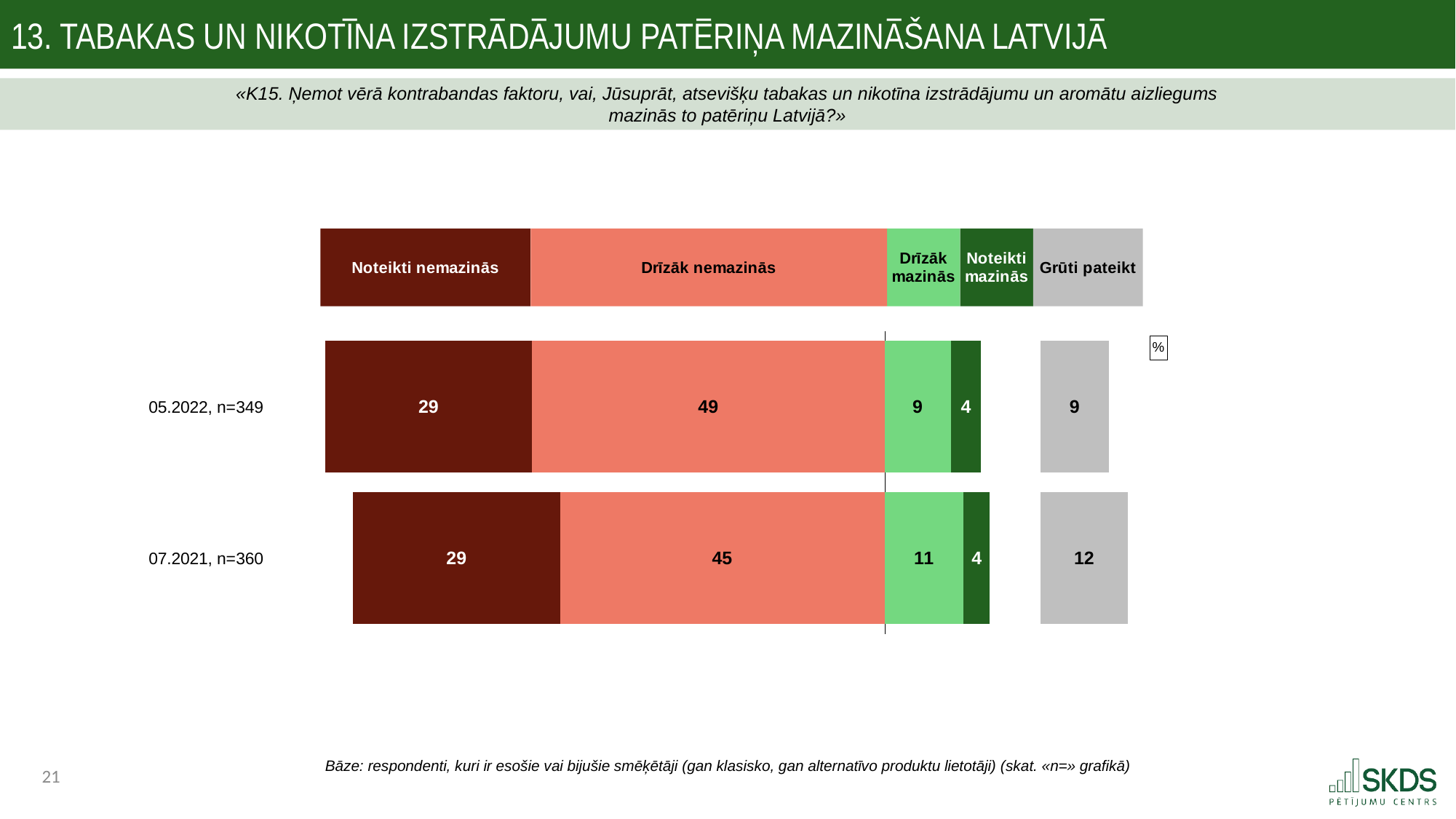
How many survey waves (rows) are shown in the chart? 2 What is the sample size (n) for the 05.2022 row? 349 What is the value for "Grūti pateikt" in the 07.2021 row? 12 How many response categories does the legend list? 5 What kind of chart is shown on the slide? Stacked bar chart Which response category has the highest value in the 07.2021 row? Drīzāk nemazinās What percentage of respondents in 05.2022 answered "Drīzāk nemazinās"? 49 Which row has the larger value for "Grūti pateikt", 05.2022 or 07.2021? 07.2021 What is the value for "Drīzāk mazinās" in the 05.2022 row? 9 What is the value for "Noteikti nemazinās" in the 07.2021 row? 29 What is the difference between the "Drīzāk nemazinās" values for 05.2022 and 07.2021? 4 Which response category has the lowest value in the 05.2022 row? Noteikti mazinās